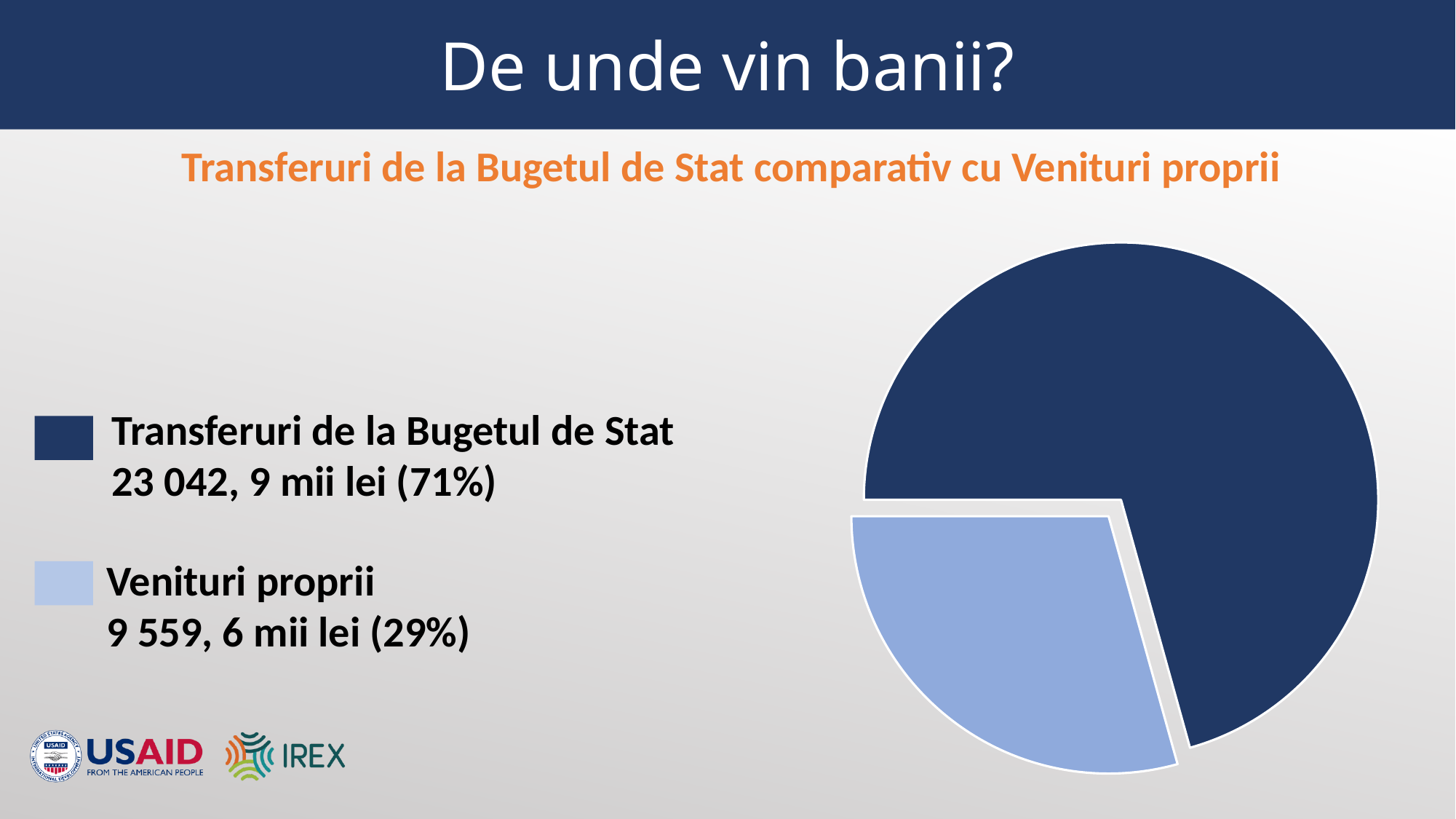
What is the difference in percentage points between the two slices? 42 Which category has the smallest slice of the pie? Venituri proprii Which colour represents Venituri proprii in the pie chart? light blue How many slices does the pie chart have? 2 What is the title of the chart? Transferuri de la Bugetul de Stat comparativ cu Venituri proprii What kind of chart is shown on the slide? pie chart Which category has the largest slice of the pie? Transferuri de la Bugetul de Stat What is the value shown for Transferuri de la Bugetul de Stat? 23 042, 9 mii lei Which is larger, Transferuri de la Bugetul de Stat or Venituri proprii? Transferuri de la Bugetul de Stat What share of the pie does Transferuri de la Bugetul de Stat represent? 71% What share of the pie does Venituri proprii represent? 29% What is the value shown for Venituri proprii? 9 559, 6 mii lei